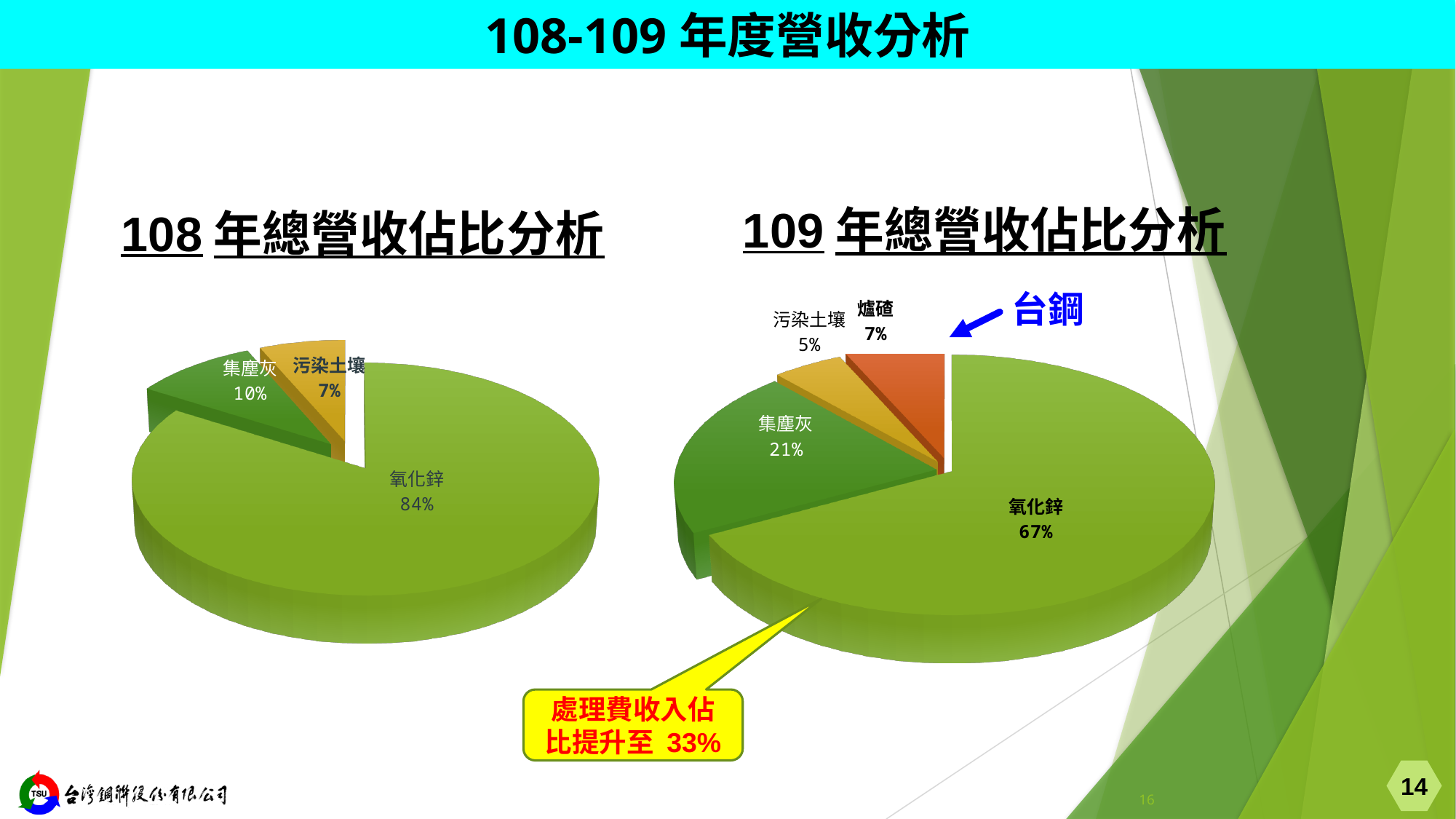
In the 109 年總營收佔比分析 chart, what share does 氧化鋅 have? 67% In the 109 年總營收佔比分析 chart, which category has the smallest share? 污染土壤 Which is larger: the 氧化鋅 share in the 108 chart or the 氧化鋅 share in the 109 chart? 108 chart How many slices does the 109 年總營收佔比分析 pie chart have? 4 In the 108 年總營收佔比分析 chart, what share does 集塵灰 have? 10% In the 108 年總營收佔比分析 chart, what share does 氧化鋅 have? 84% In the 109 年總營收佔比分析 chart, what share does 污染土壤 have? 5% How many slices does the 108 年總營收佔比分析 pie chart have? 3 What type of chart is used for the 108 年總營收佔比分析? Pie chart In the 108 年總營收佔比分析 chart, which category has the largest share? 氧化鋅 What is the difference between the 集塵灰 share in the 109 chart and the 集塵灰 share in the 108 chart? 11% In the 109 年總營收佔比分析 chart, what share does 爐碴 have? 7%